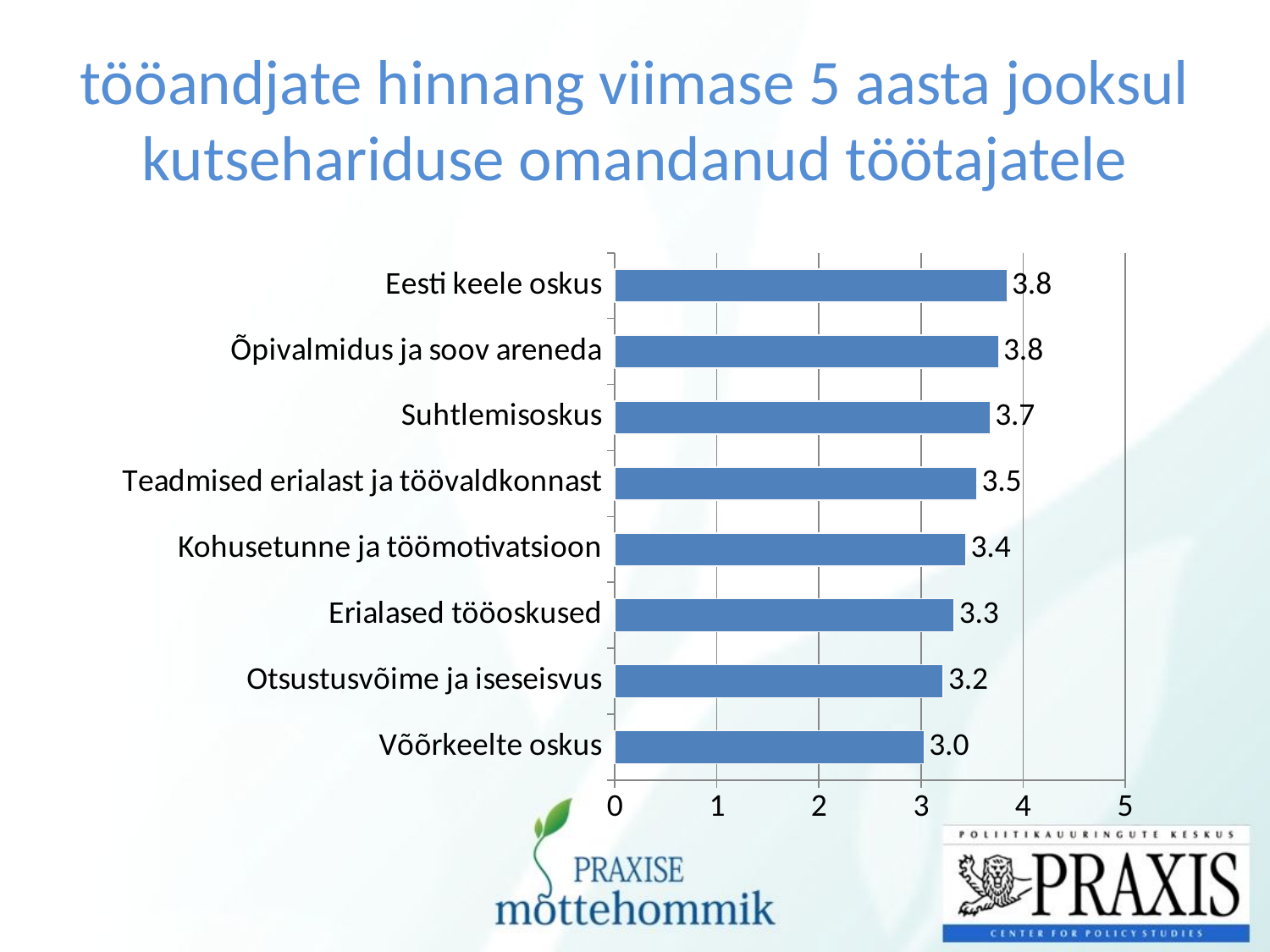
What is the value for Suhtlemisoskus? 3.7 How many categories are shown in the chart? 8 What is the difference between the values for Teadmised erialast ja töövaldkonnast and Erialased tööoskused? 0.2 What kind of chart is shown on the slide? bar chart Is the value for Õpivalmidus ja soov areneda greater or less than 3? greater Which category has the lowest value? Võõrkeelte oskus Which is larger, the value for Suhtlemisoskus or the value for Erialased tööoskused? Suhtlemisoskus What is the value for Võõrkeelte oskus? 3.0 What is the difference between the values for Eesti keele oskus and Võõrkeelte oskus? 0.8 What is the value for Kohusetunne ja töömotivatsioon? 3.4 What is the value for Otsustusvõime ja iseseisvus? 3.2 What is the highest value shown on the x axis? 5